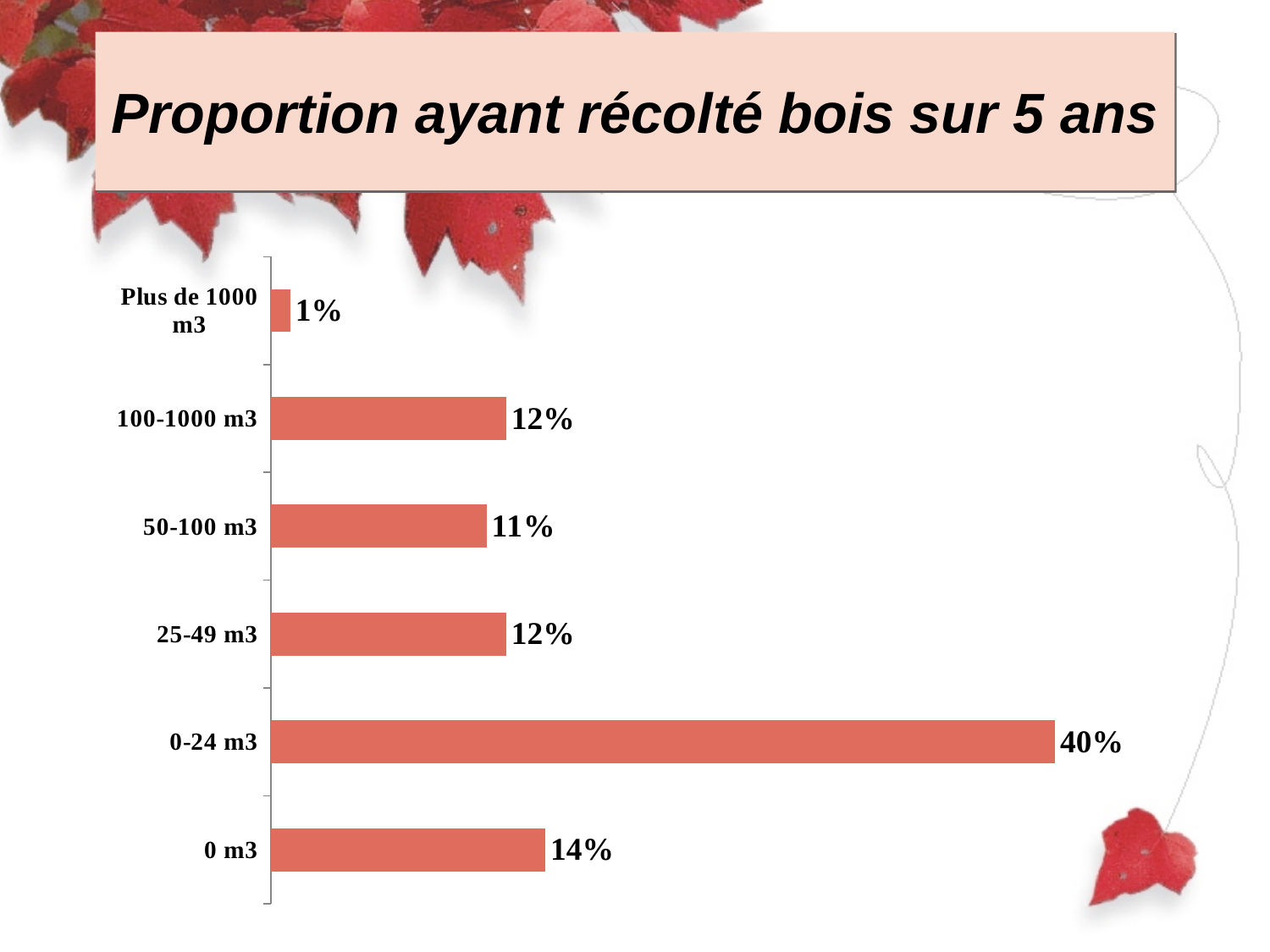
Which category has the lowest value? Plus de 1000 m3 What is the difference between the values for 100-1000 m3 and Plus de 1000 m3? 11% What is the value for the Plus de 1000 m3 category? 1% What is the value for the 0-24 m3 category? 40% What is the difference between the values for 0-24 m3 and 0 m3? 26% What is the value for the 0 m3 category? 14% Which is larger, the value for 0 m3 or the value for 25-49 m3? 0 m3 Which category has the highest value? 0-24 m3 How many categories are shown in the chart? 6 What kind of chart is shown on the slide? Bar chart What is the title of the slide? Proportion ayant récolté bois sur 5 ans What is the value for the 50-100 m3 category? 11%